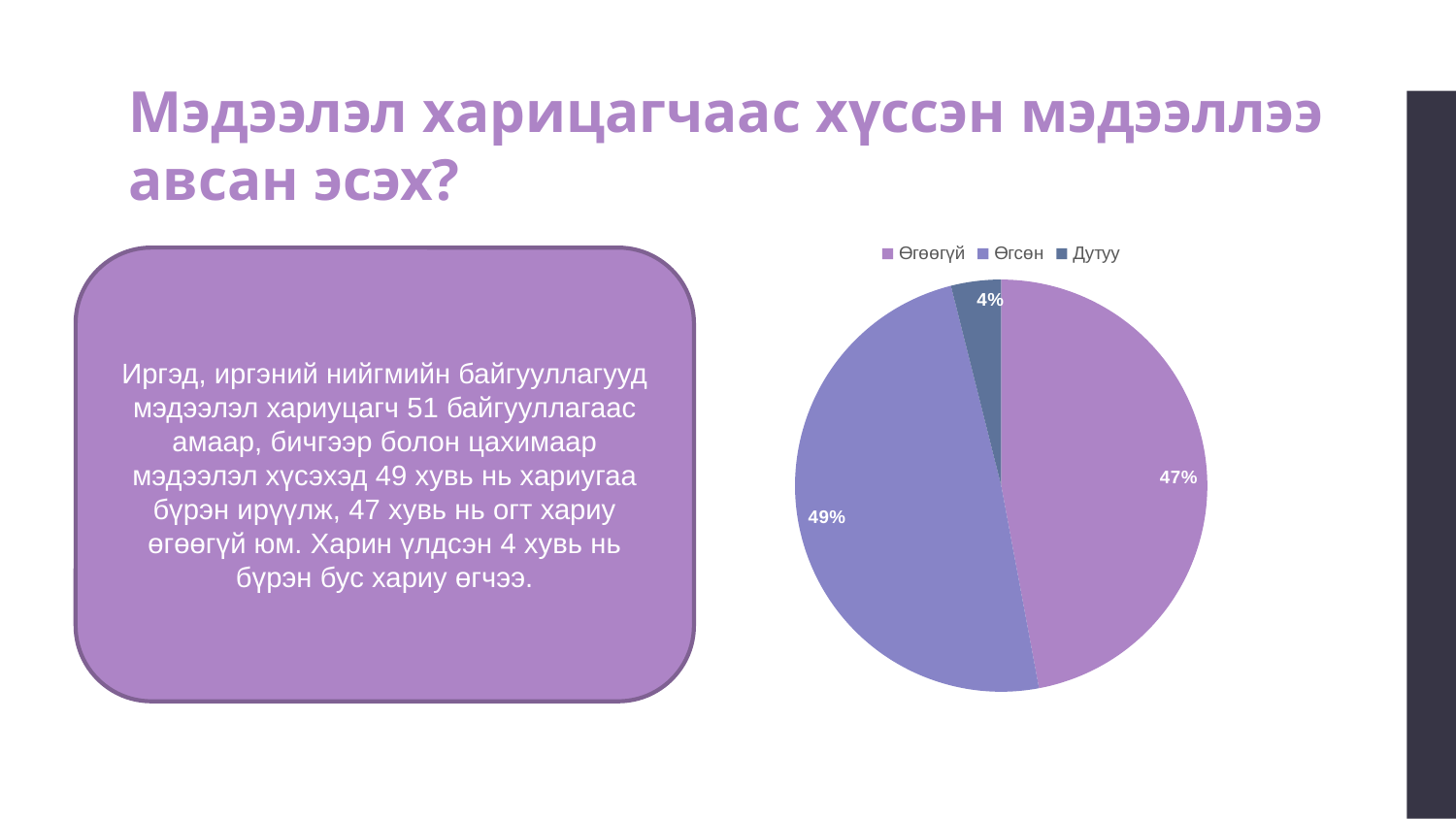
What is the difference in percentage points between Өгсөн and Өгөөгүй? 2 Which is larger, the slice for Өгөөгүй or the slice for Дутуу? Өгөөгүй How many entries does the legend of the pie chart list? 3 What share of the pie does Өгөөгүй have? 47% Which category has the largest slice of the pie? Өгсөн What kind of chart is shown on the slide? pie chart How many slices does the pie chart have? 3 What share of the pie does Дутуу have? 4% What share of the pie does Өгсөн have? 49% Which legend entry is listed first in the pie chart's legend? Өгөөгүй Which category has the smallest slice of the pie? Дутуу What is the difference in percentage points between Өгөөгүй and Дутуу? 43